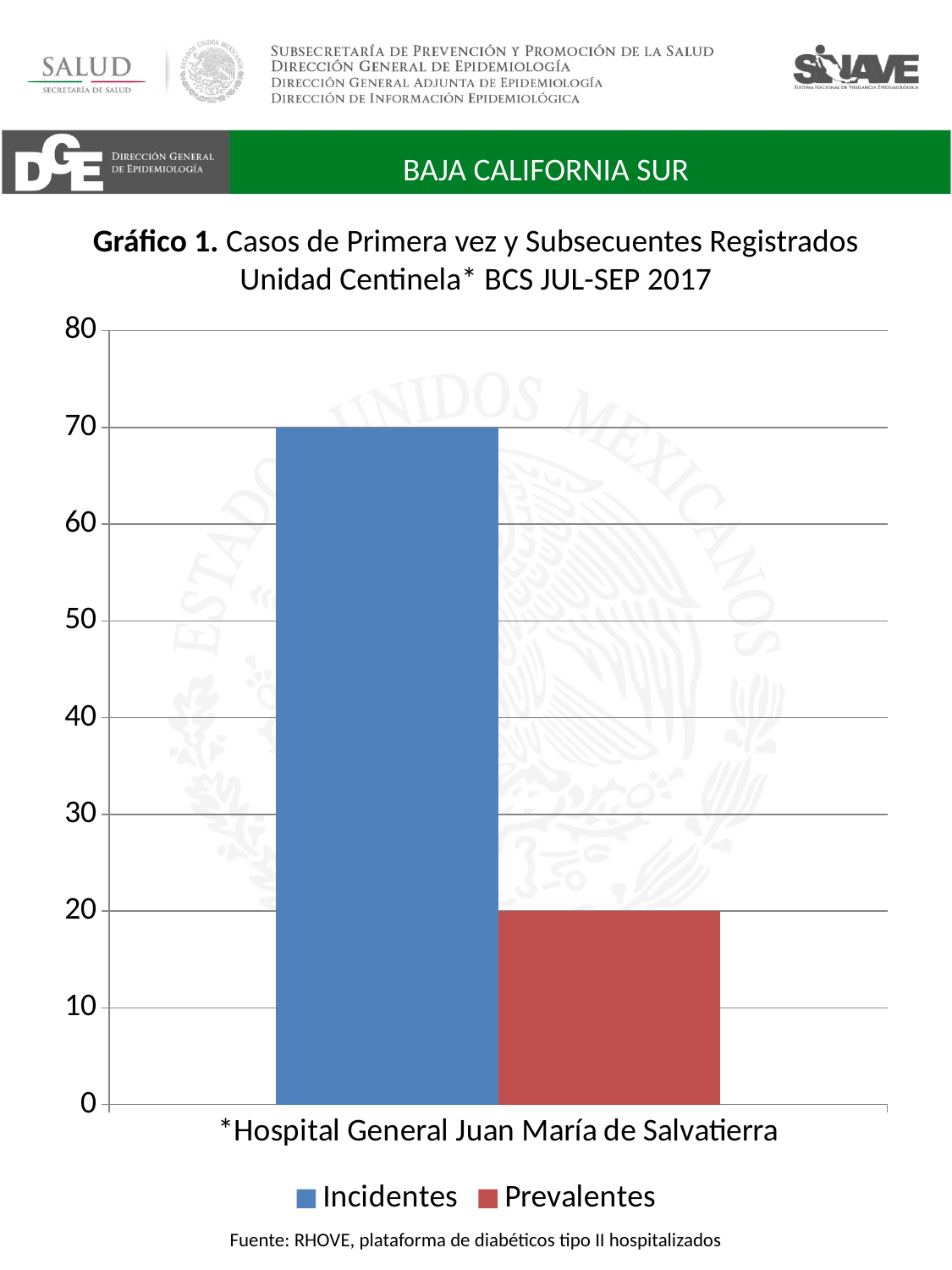
Which series has the higher value, Incidentes or Prevalentes? Incidentes Is the value for Prevalentes greater or less than 30? less What is the value for Prevalentes? 20 What colour is the bar for Prevalentes? Red How many series does the legend list? 2 What is the category label shown on the horizontal axis? *Hospital General Juan María de Salvatierra What is the maximum value shown on the vertical axis? 80 Which series has the lowest value? Prevalentes Is the value for Incidentes greater or less than 60? greater What is the difference between the Incidentes and Prevalentes values? 50 What kind of chart is shown on the slide? Bar chart What is the value for Incidentes? 70